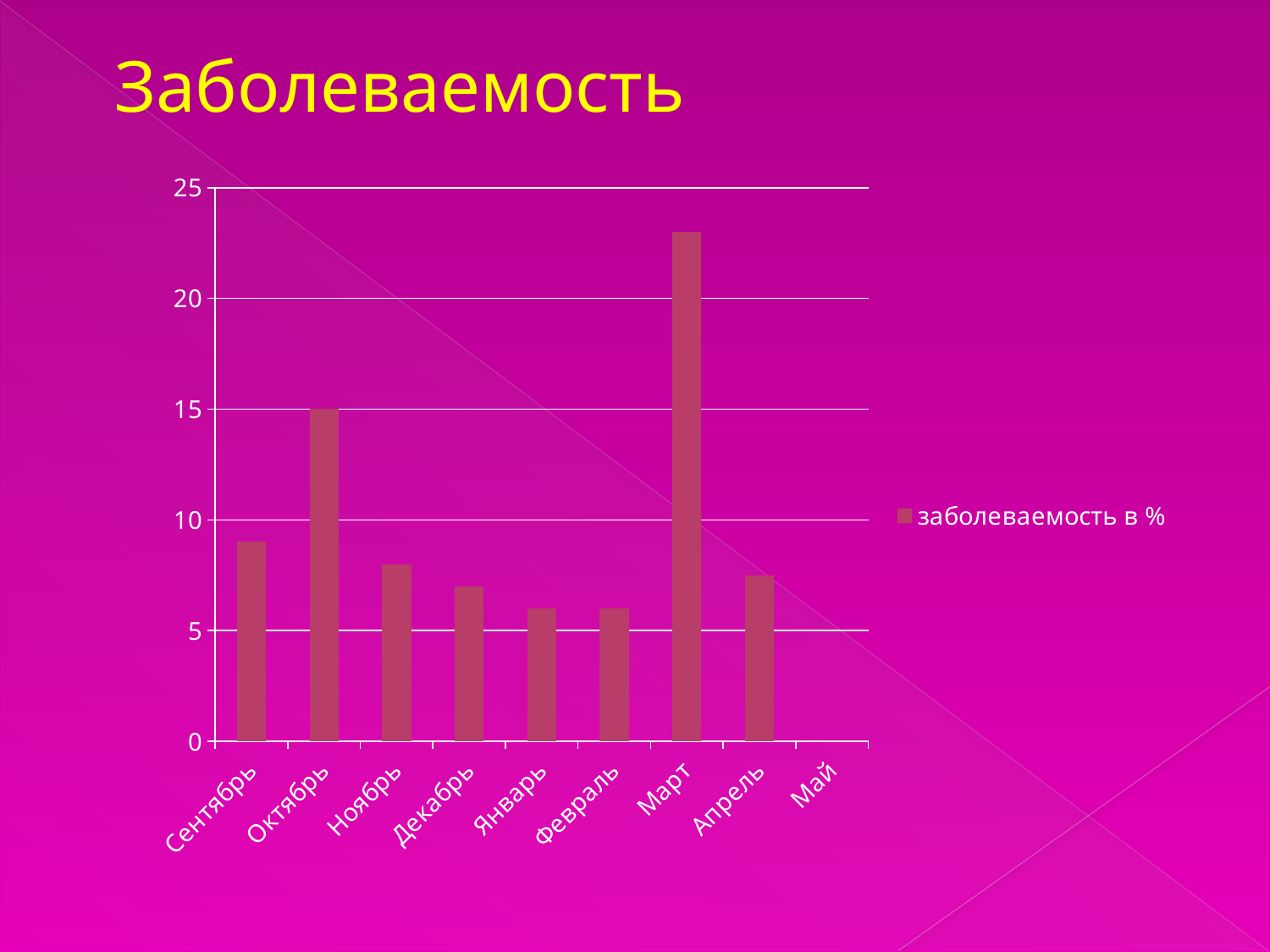
Is the value for Январь greater or less than 5? greater What is the legend entry for the series? заболеваемость в % Which month has the highest value? Март What is the title of the chart? Заболеваемость What is the value for Октябрь? 15 Is the value for Сентябрь greater or less than 10? less Which is larger, the value for Октябрь or the value for Апрель? Октябрь What kind of chart is shown on the slide? bar chart Is the value for Март greater or less than 20? greater How many series does the legend list? 1 Do the values rise or fall from Октябрь to Январь? fall How many categories are shown on the x axis? 9